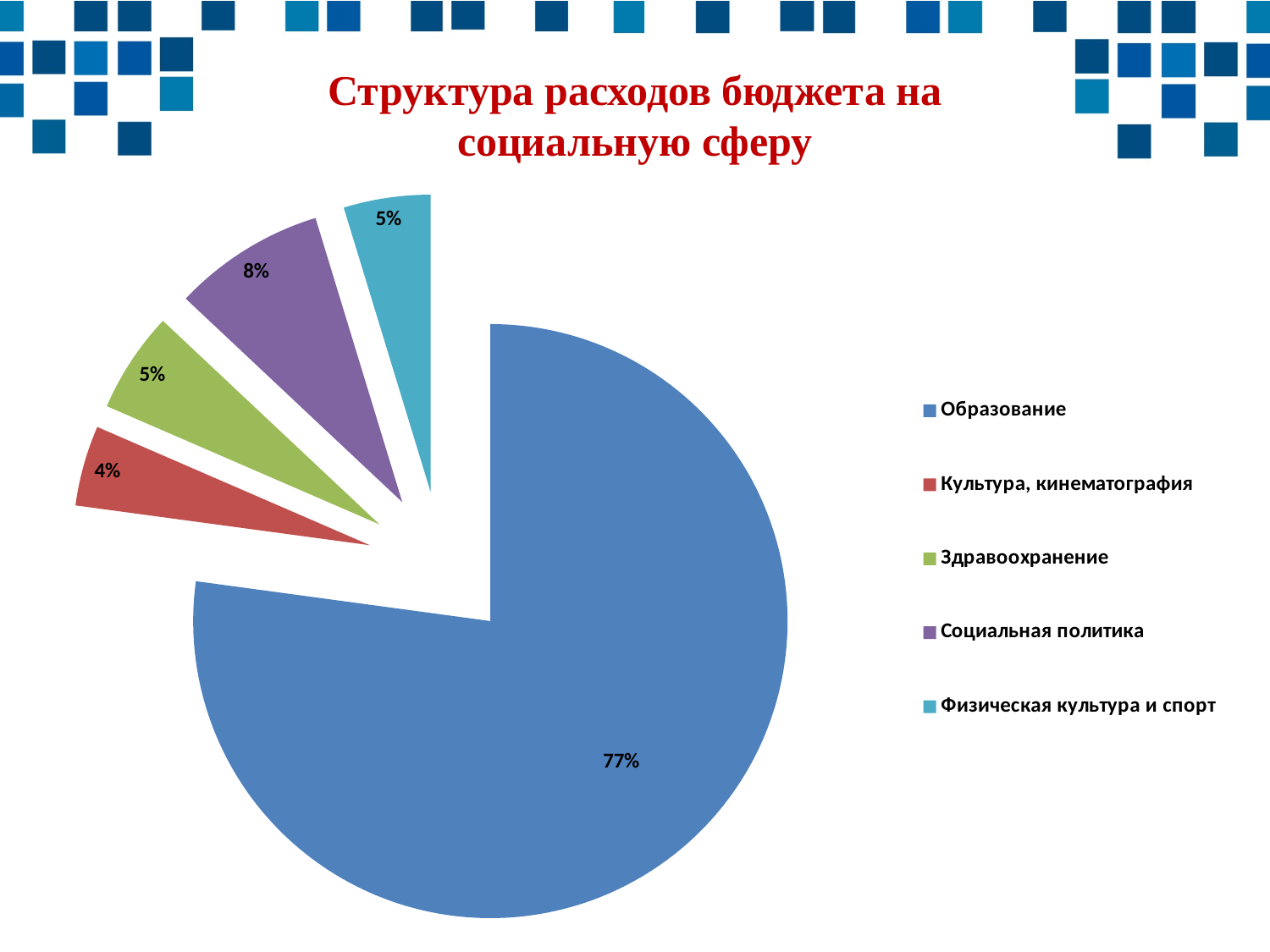
Which category has the largest share of the pie? Образование What share of the pie does Здравоохранение take? 5% What is the difference in percentage points between Образование and Социальная политика? 69 What share of the pie does Физическая культура и спорт take? 5% How many categories does the pie chart have? 5 What is the title of the chart on the slide? Структура расходов бюджета на социальную сферу Which category has the smallest share of the pie? Культура, кинематография What share of the pie does Социальная политика take? 8% Which is larger, the share for Социальная политика or the share for Здравоохранение? Социальная политика What kind of chart is shown on the slide? pie chart